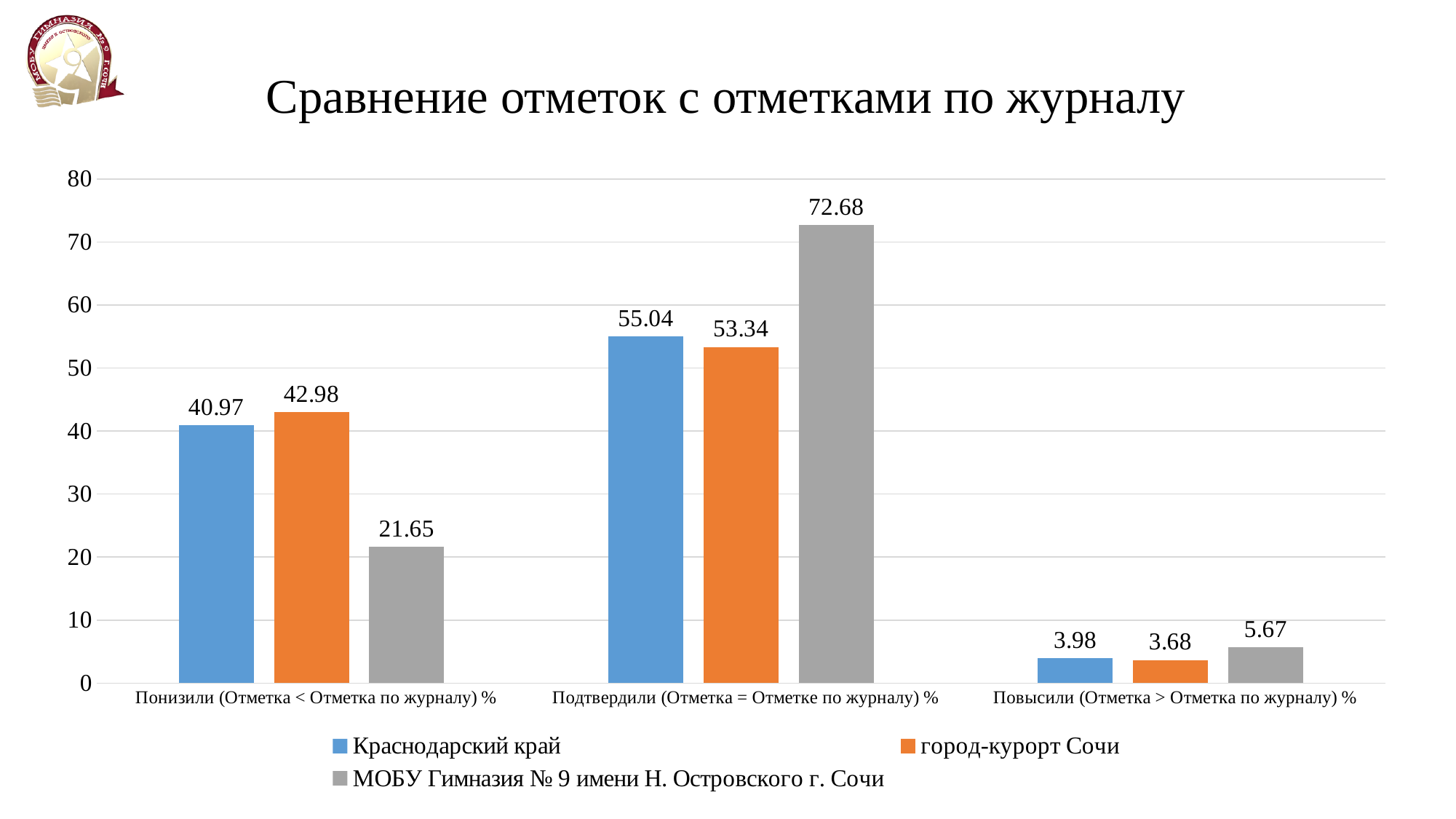
What type of chart is shown on the slide? Bar chart What is the value for МОБУ Гимназия № 9 имени Н. Островского г. Сочи in the Подтвердили category? 72.68 Which series has the lowest value in the Понизили category? МОБУ Гимназия № 9 имени Н. Островского г. Сочи Which series has the highest value in the Подтвердили category? МОБУ Гимназия № 9 имени Н. Островского г. Сочи What is the value for город-курорт Сочи in the Повысили category? 3.68 What is the difference between город-курорт Сочи and Краснодарский край in the Понизили category? 2.01 How many series does the legend list? 3 Is the value for город-курорт Сочи in the Подтвердили category greater or less than 50? greater How many categories are shown on the x axis? 3 What is the value for Краснодарский край in the Понизили category? 40.97 In the Повысили category, which is larger: the value for Краснодарский край or for МОБУ Гимназия № 9? МОБУ Гимназия № 9 имени Н. Островского г. Сочи What is the difference between the МОБУ Гимназия № 9 value and the Краснодарский край value in the Подтвердили category? 17.64